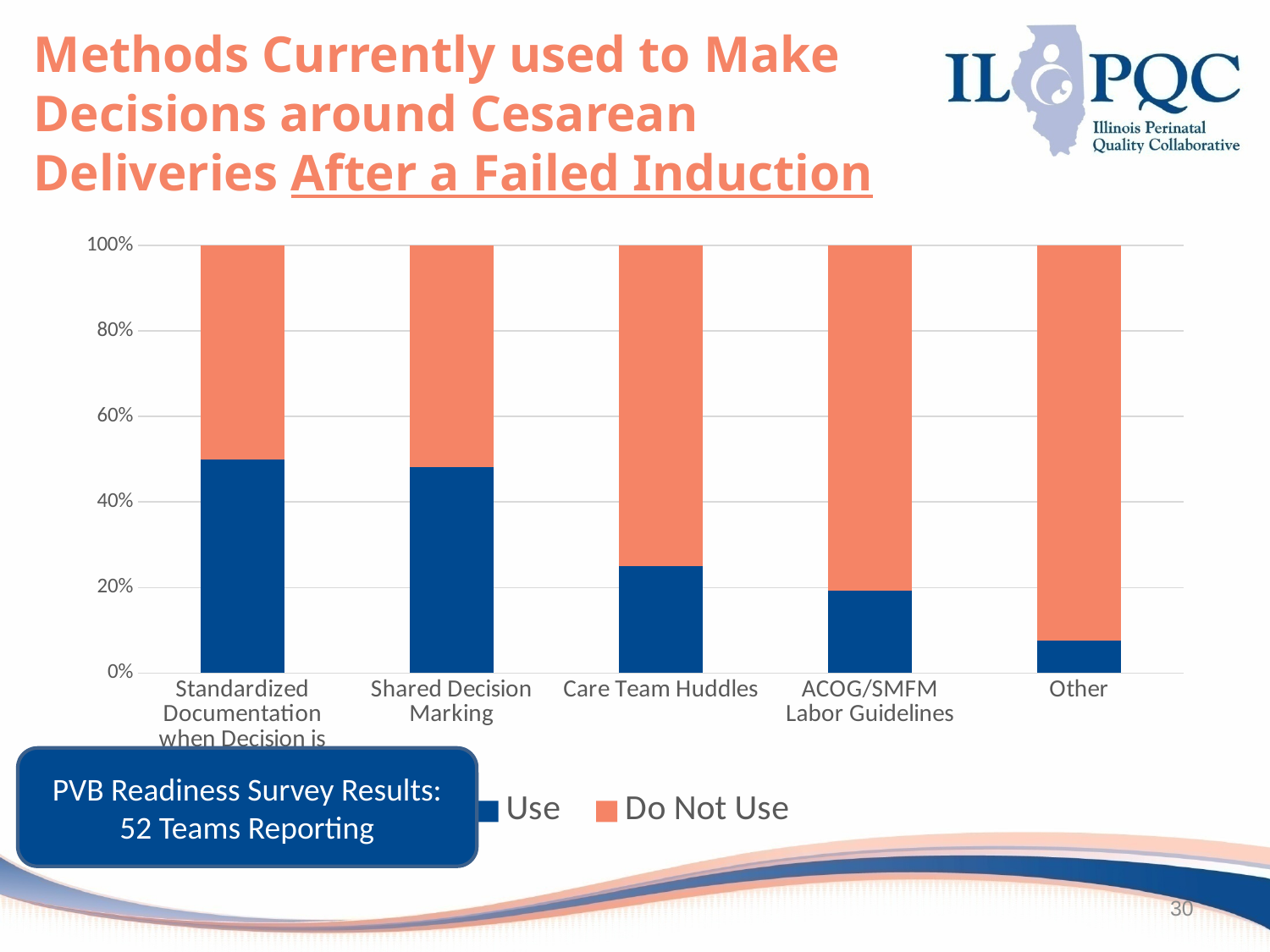
Is the 'Use' value for ACOG/SMFM Labor Guidelines greater or less than 40%? less What is the total height of the stacked bar for Care Team Huddles? 100% Is the 'Use' value for Shared Decision Marking greater or less than 40%? greater Which category has the highest 'Do Not Use' value? Other How many categories are shown along the x axis of the chart? 5 Is the 'Use' value for Other greater or less than 20%? less What kind of chart is shown on the slide? bar chart Which is larger, the 'Use' value for Care Team Huddles or the 'Use' value for Other? Care Team Huddles How many series does the chart's legend list? 2 Which category has the lowest 'Use' value? Other What are the two entries in the chart's legend? Use, Do Not Use